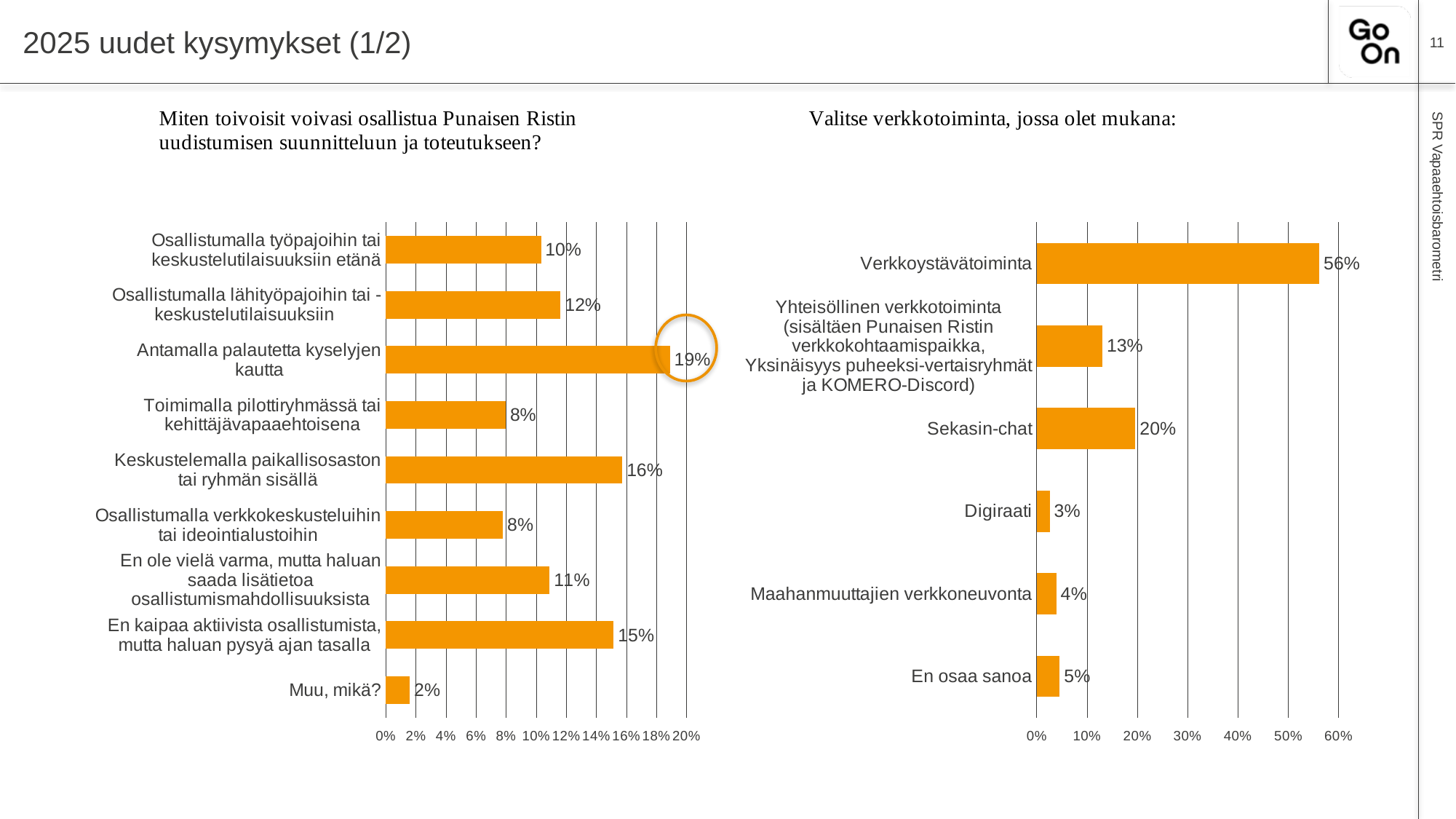
What type of chart is the right chart? Bar chart In the right chart, which category has the lowest value? Digiraati In the left chart, which category has the lowest value? Muu, mikä? In the right chart, which category has the highest value? Verkkoystävätoiminta In the right chart, what is the difference between 'Verkkoystävätoiminta' and 'Sekasin-chat'? 36% In the left chart, how many categories are shown? 9 In the right chart, how many categories are shown? 6 In the left chart (Miten toivoisit voivasi osallistua...), what is the value for 'Antamalla palautetta kyselyjen kautta'? 19% In the right chart (Valitse verkkotoiminta, jossa olet mukana), what is the value for 'Sekasin-chat'? 20% In the left chart, what is the difference between 'Keskustelemalla paikallisosaston tai ryhmän sisällä' and 'Toimimalla pilottiryhmässä tai kehittäjävapaaehtoisena'? 8% In the right chart, which is larger: 'Maahanmuuttajien verkkoneuvonta' or 'En osaa sanoa'? En osaa sanoa In the left chart, which category has the highest value? Antamalla palautetta kyselyjen kautta